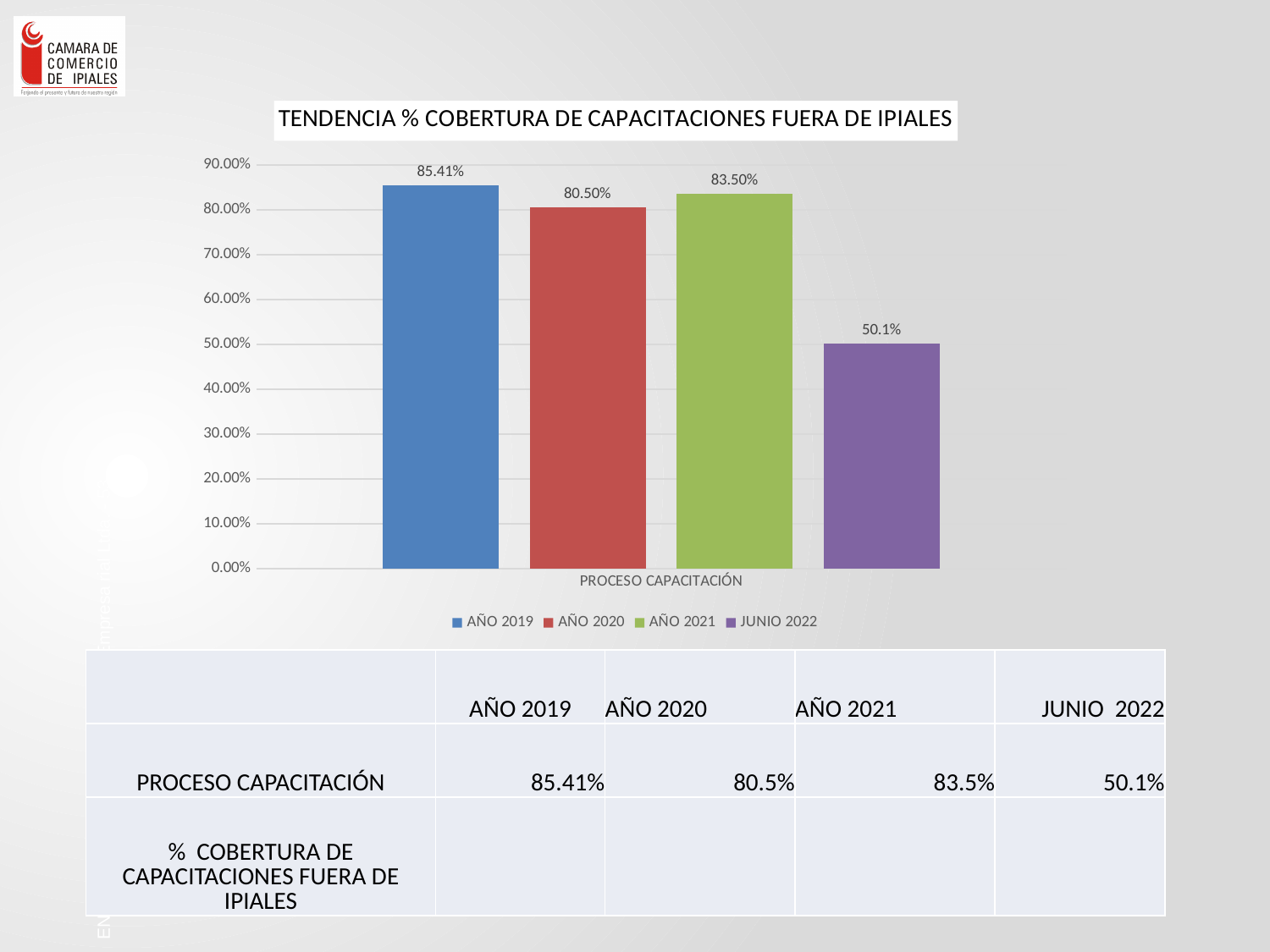
Which is larger, the value for AÑO 2021 or the value for AÑO 2020? AÑO 2021 Is the value for JUNIO 2022 greater or less than 60.00%? less What is the difference between the values for AÑO 2019 and AÑO 2020? 4.91% What is the value for AÑO 2021 in the chart? 83.50% What is the value for JUNIO 2022 in the chart? 50.1% What is the value for AÑO 2019 in the chart? 85.41% What is the title of the chart? TENDENCIA % COBERTURA DE CAPACITACIONES FUERA DE IPIALES What kind of chart is shown on the slide? bar chart How many series does the legend list? 4 Which series has the lowest value in the chart? JUNIO 2022 Which series has the highest value in the chart? AÑO 2019 What is the value for AÑO 2020 in the chart? 80.50%